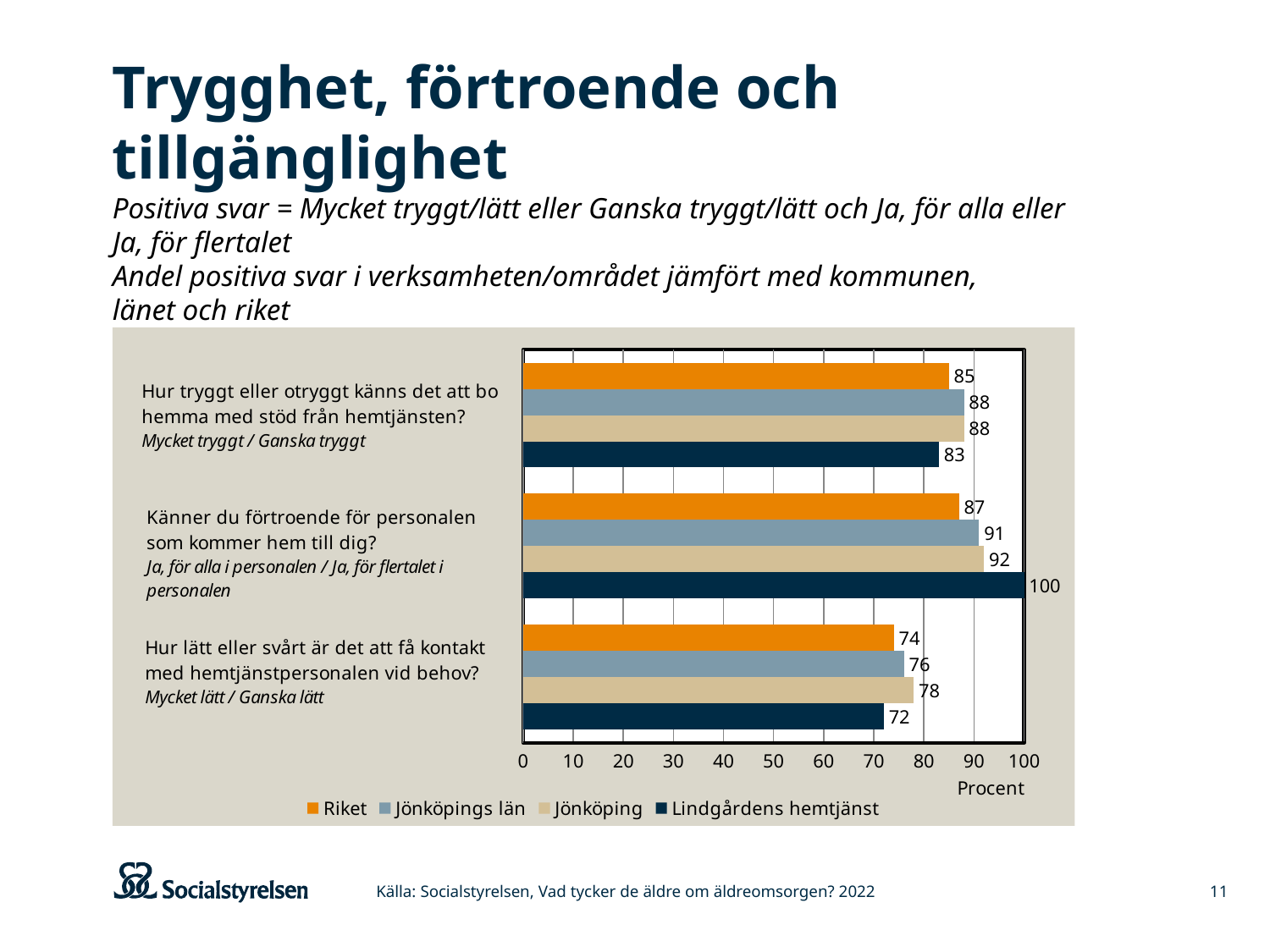
What unit is shown on the x axis of the chart? Procent Which series has the lowest value on the question "Hur lätt eller svårt är det att få kontakt med hemtjänstpersonalen vid behov?" Lindgårdens hemtjänst How many question categories are plotted on the chart? 3 Which is larger on the question "Hur tryggt eller otryggt känns det att bo hemma med stöd från hemtjänsten?": Riket or Lindgårdens hemtjänst? Riket Which series has the highest value on the question "Känner du förtroende för personalen som kommer hem till dig?" Lindgårdens hemtjänst What is the value for Riket on the question "Hur lätt eller svårt är det att få kontakt med hemtjänstpersonalen vid behov?" 74 How many series does the legend list? 4 What is the difference between Jönköping and Jönköpings län on the question "Hur lätt eller svårt är det att få kontakt med hemtjänstpersonalen vid behov?" 2 What is the value for Jönköping on the question "Hur tryggt eller otryggt känns det att bo hemma med stöd från hemtjänsten?" 88 What kind of chart is shown on the slide? Bar chart What is the difference between Lindgårdens hemtjänst and Riket on the question "Känner du förtroende för personalen som kommer hem till dig?" 13 What is the value for Lindgårdens hemtjänst on the question "Känner du förtroende för personalen som kommer hem till dig?" 100